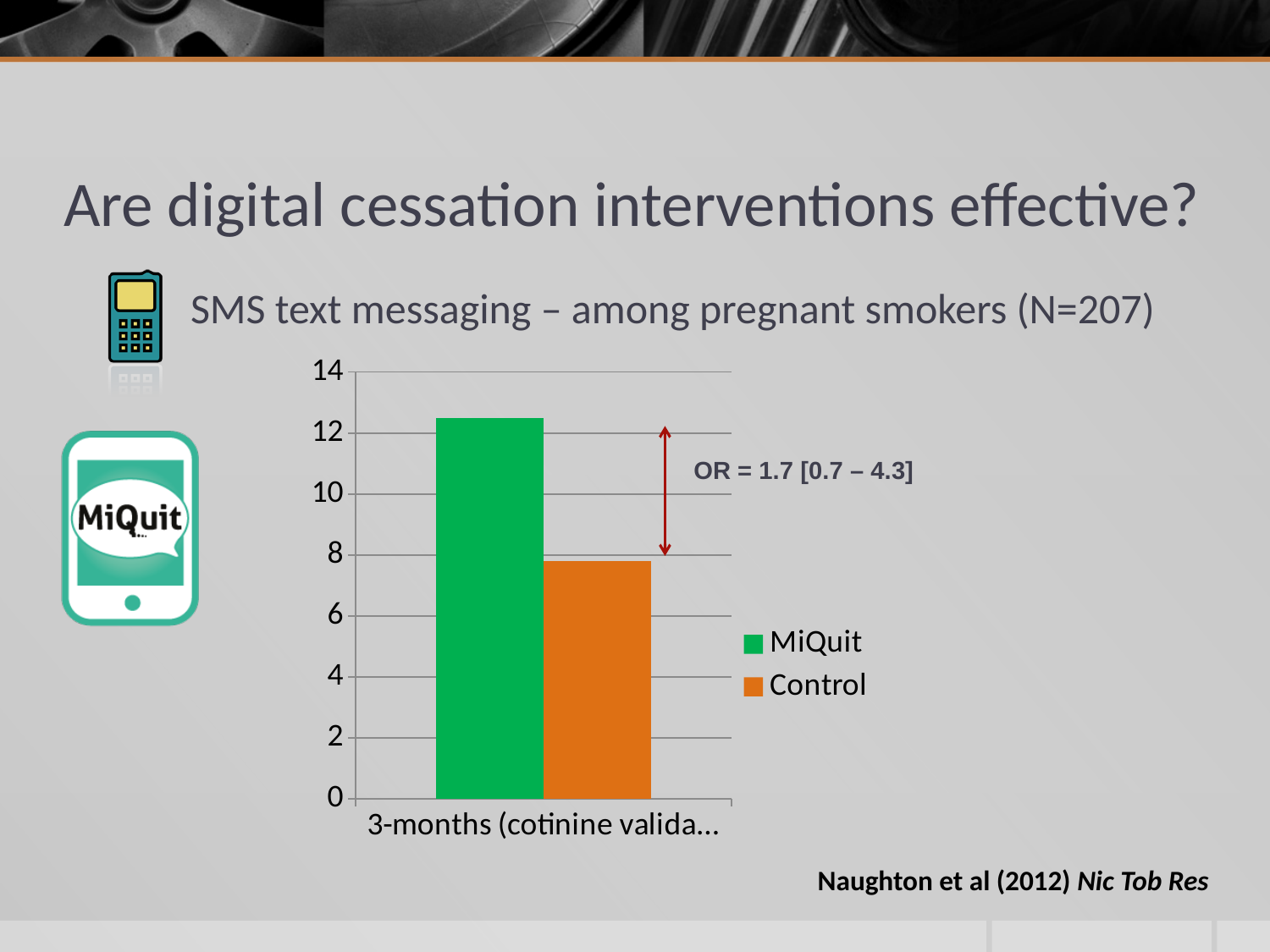
Which series has the lowest bar in the chart? Control What colour is the bar for the Control series? orange Is the value for Control greater or less than 6? greater What odds ratio is annotated between the two bars on the chart? OR = 1.7 [0.7 – 4.3] How many categories are plotted on the x axis of the chart? 1 How many series does the chart legend list? 2 What kind of chart is shown on the slide? bar chart Is the value for MiQuit greater or less than 12? greater Is the value for MiQuit greater or less than 14? less Which series has the taller bar, MiQuit or Control? MiQuit